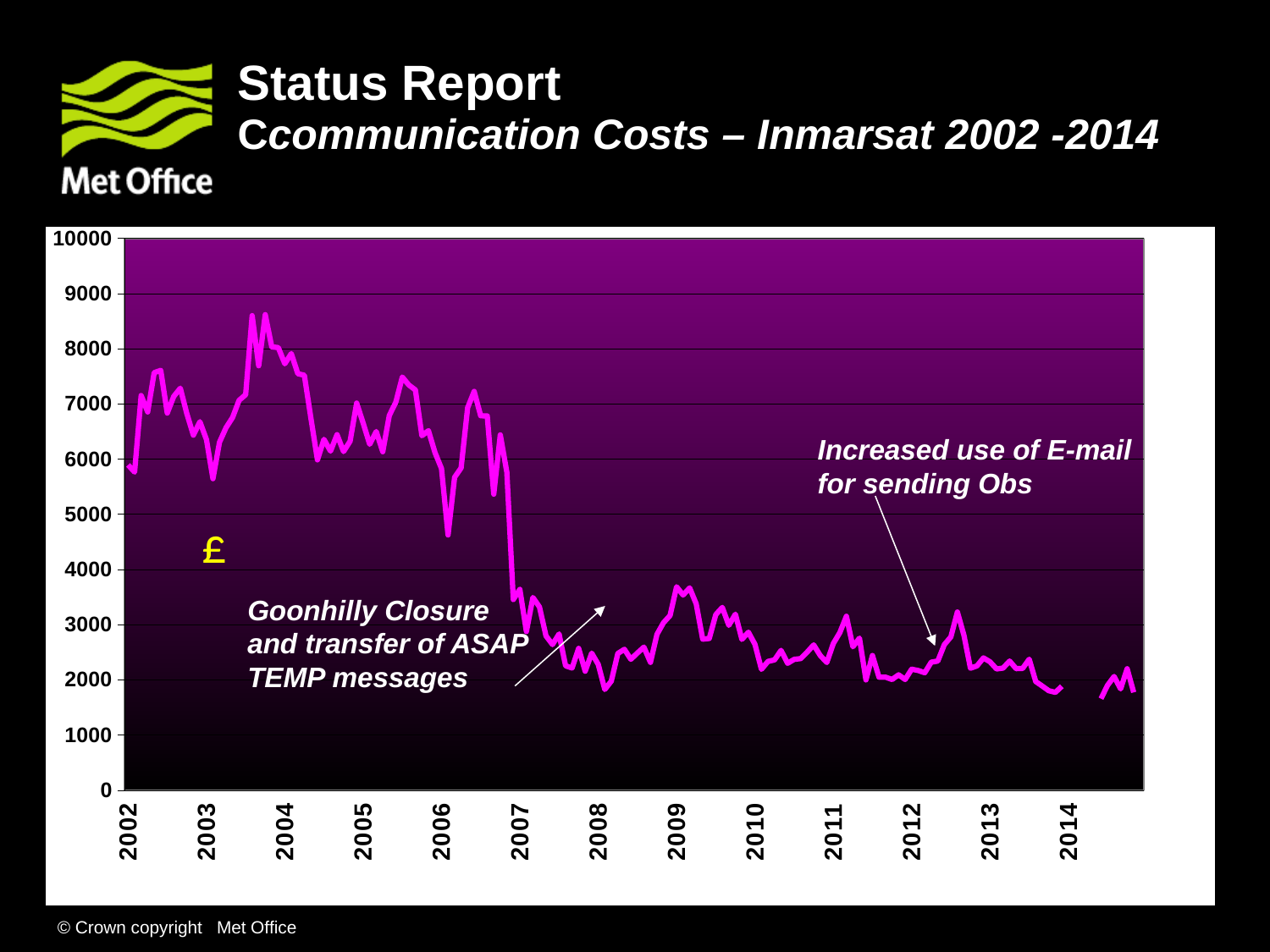
What currency symbol is shown on the chart? £ How many year labels are shown along the x axis? 13 What event does the chart annotation give as the reason for the sharp drop in costs around 2007? Goonhilly Closure and transfer of ASAP TEMP messages Is the value at the start of 2005 greater or less than 5000? greater Is the value at the start of 2008 greater or less than 3000? less Is the value at the start of 2012 greater or less than 3000? less What kind of chart is shown on the slide? line chart Overall, do the Inmarsat communication costs rise or fall from 2002 to 2014? fall Which is larger, the value at the start of 2004 or the value at the start of 2010? 2004